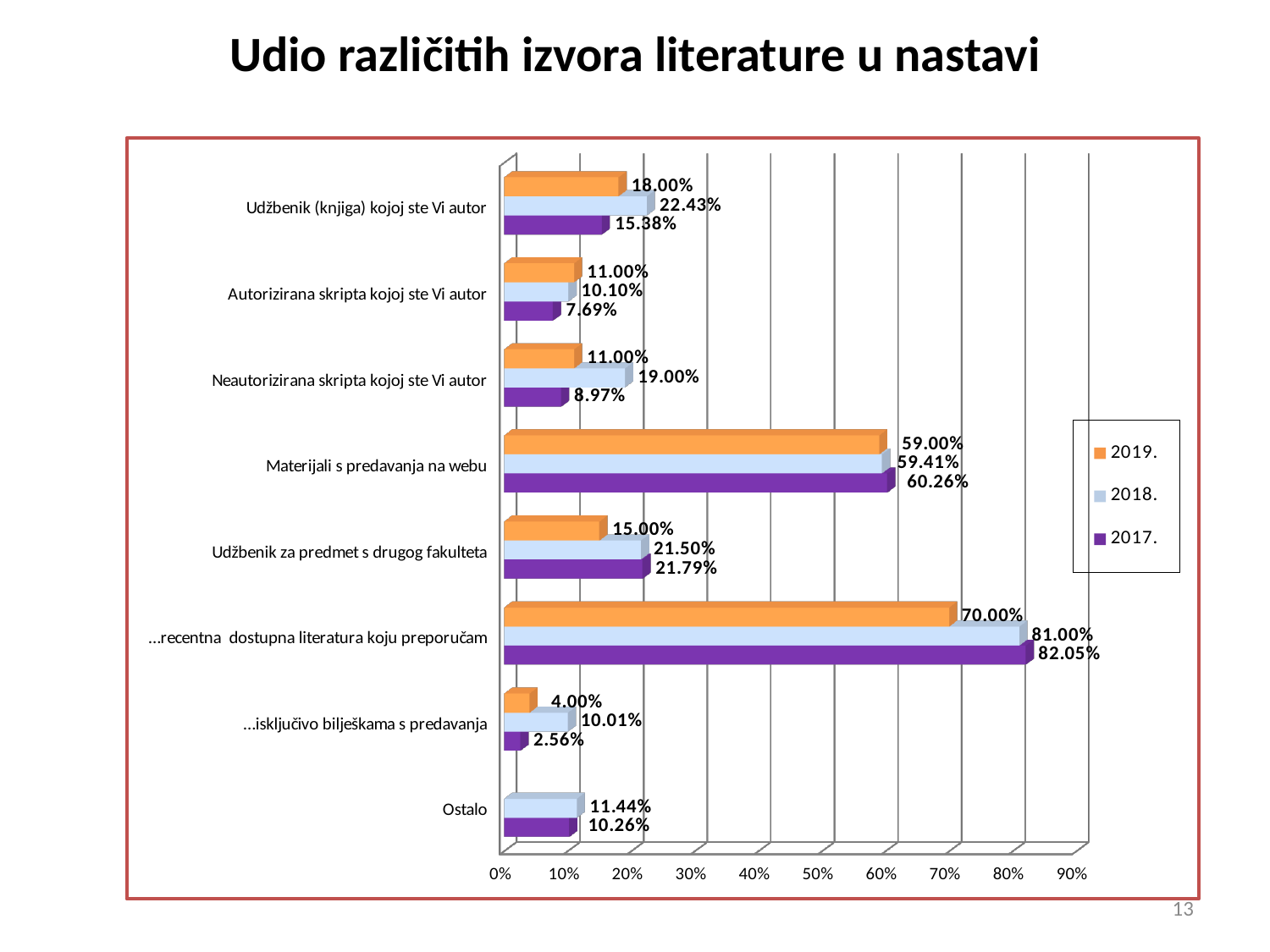
What kind of chart is shown on the slide? Bar chart What is the difference between the 2018. and 2019. values for "...recentna dostupna literatura koju preporučam"? 11.00% What are the entries in the chart's legend? 2019., 2018., 2017. Which category has the lowest 2017. value? ...isključivo bilješkama s predavanja For "Neautorizirana skripta kojoj ste Vi autor", which is larger: the 2018. value or the 2017. value? 2018. What is the 2017. value for "Materijali s predavanja na webu"? 60.26% How many categories are shown on the chart? 8 What is the 2018. value for "Ostalo"? 11.44% How many series does the legend list? 3 What is the 2019. value for "...isključivo bilješkama s predavanja"? 4.00% What is the 2018. value for "Udžbenik (knjiga) kojoj ste Vi autor"? 22.43% Which category has the highest 2017. value? ...recentna dostupna literatura koju preporučam